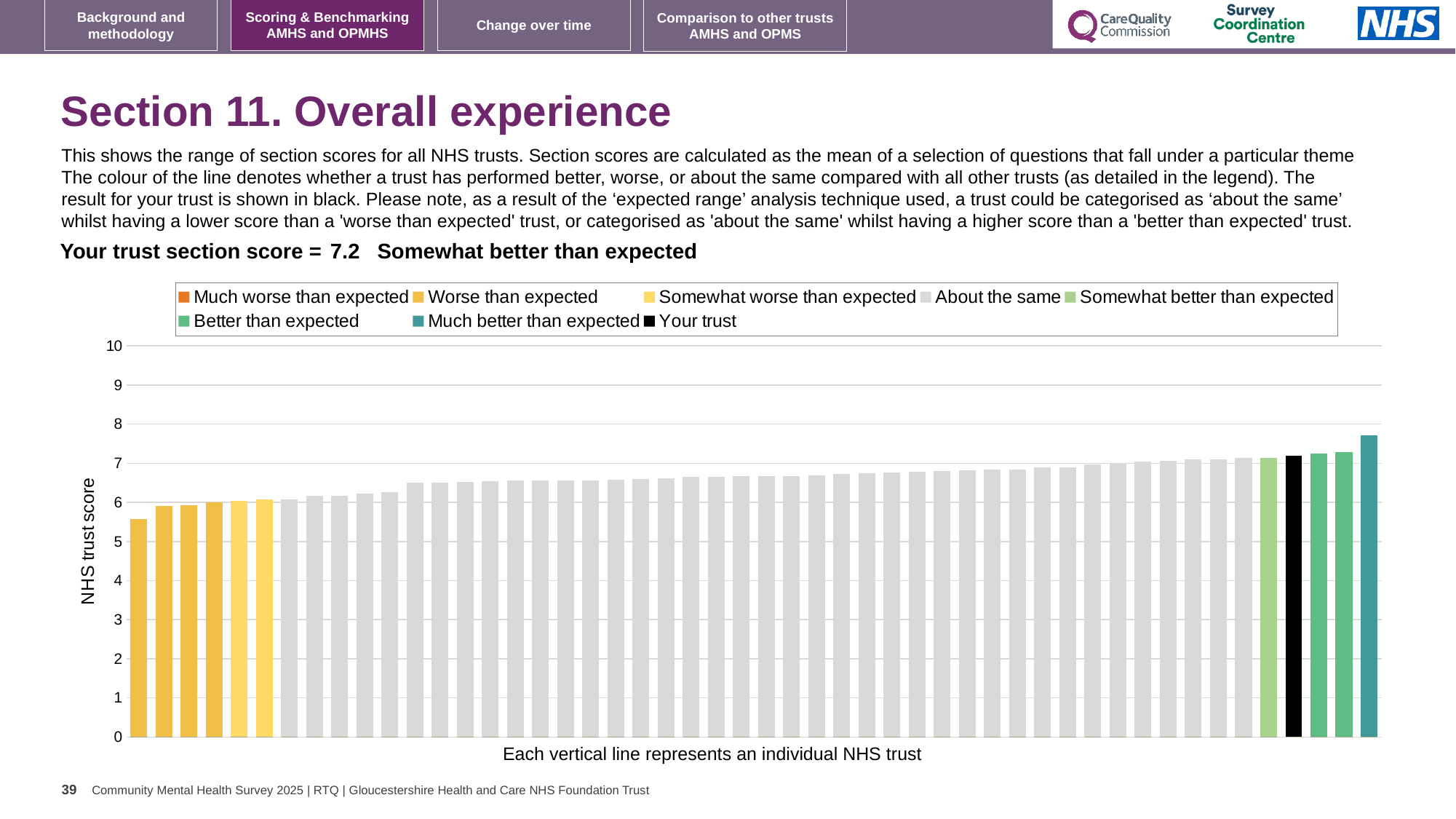
How many bars are coloured as 'Better than expected' (green)? 2 Is the value for the tallest bar in the chart greater or less than 8? less What is the section score for your trust shown on the slide? 7.2 How many bars are coloured as 'Much better than expected' (teal)? 1 Is the value for the lowest bar in the chart greater or less than 6? less Which is larger, the value of the black 'Your trust' bar or the value of the leftmost bar? Your trust Which category does your trust's section score fall into according to the slide? Somewhat better than expected What kind of chart is shown on the slide? Bar chart What is the label on the vertical axis of the chart? NHS trust score How many entries does the chart legend list? 8 Do the bar values rise or fall from left to right across the chart? rise Is the value for the black 'Your trust' bar greater or less than 7? greater